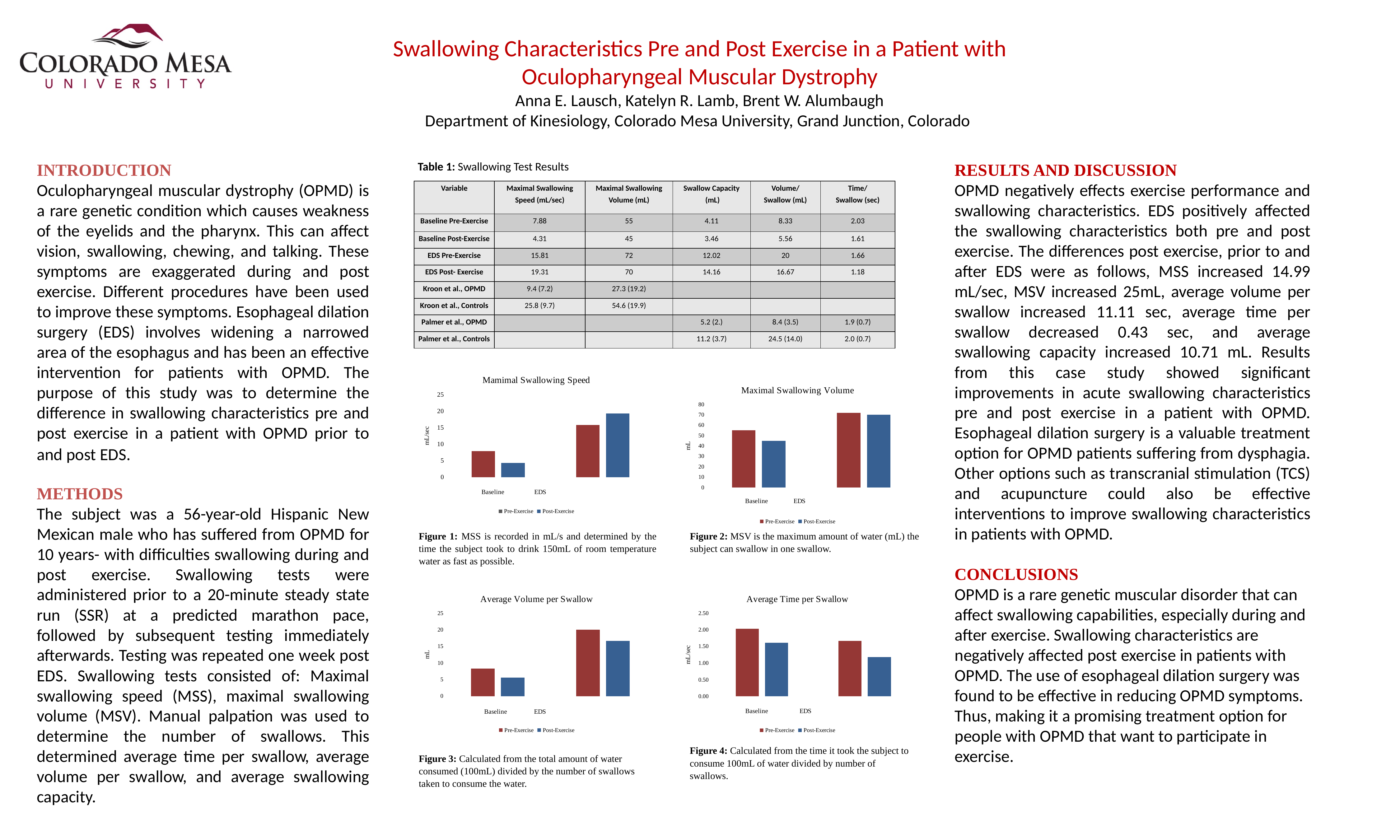
In the Maximal Swallowing Speed chart, which is larger for Baseline: Pre-Exercise or Post-Exercise? Pre-Exercise In the Maximal Swallowing Volume chart, is the EDS Pre-Exercise value greater or less than 60? greater In the Maximal Swallowing Speed chart, which bar is the highest? EDS Post-Exercise In the Average Time per Swallow chart, which bar is the highest? Baseline Pre-Exercise In the Average Volume per Swallow chart, which is larger for EDS: Pre-Exercise or Post-Exercise? Pre-Exercise In the Maximal Swallowing Speed chart, how many series does the legend list? 2 In the Average Volume per Swallow chart, how many category groups are shown on the x axis? 2 In the Average Volume per Swallow chart, is the Baseline Post-Exercise value greater or less than 10? less In the Maximal Swallowing Volume chart, which bar is the lowest? Baseline Post-Exercise In the Average Time per Swallow chart, which bar is the lowest? EDS Post-Exercise In the Maximal Swallowing Speed chart, is the Baseline Pre-Exercise value greater or less than 10? less In the Maximal Swallowing Speed chart, what kind of chart is shown? bar chart